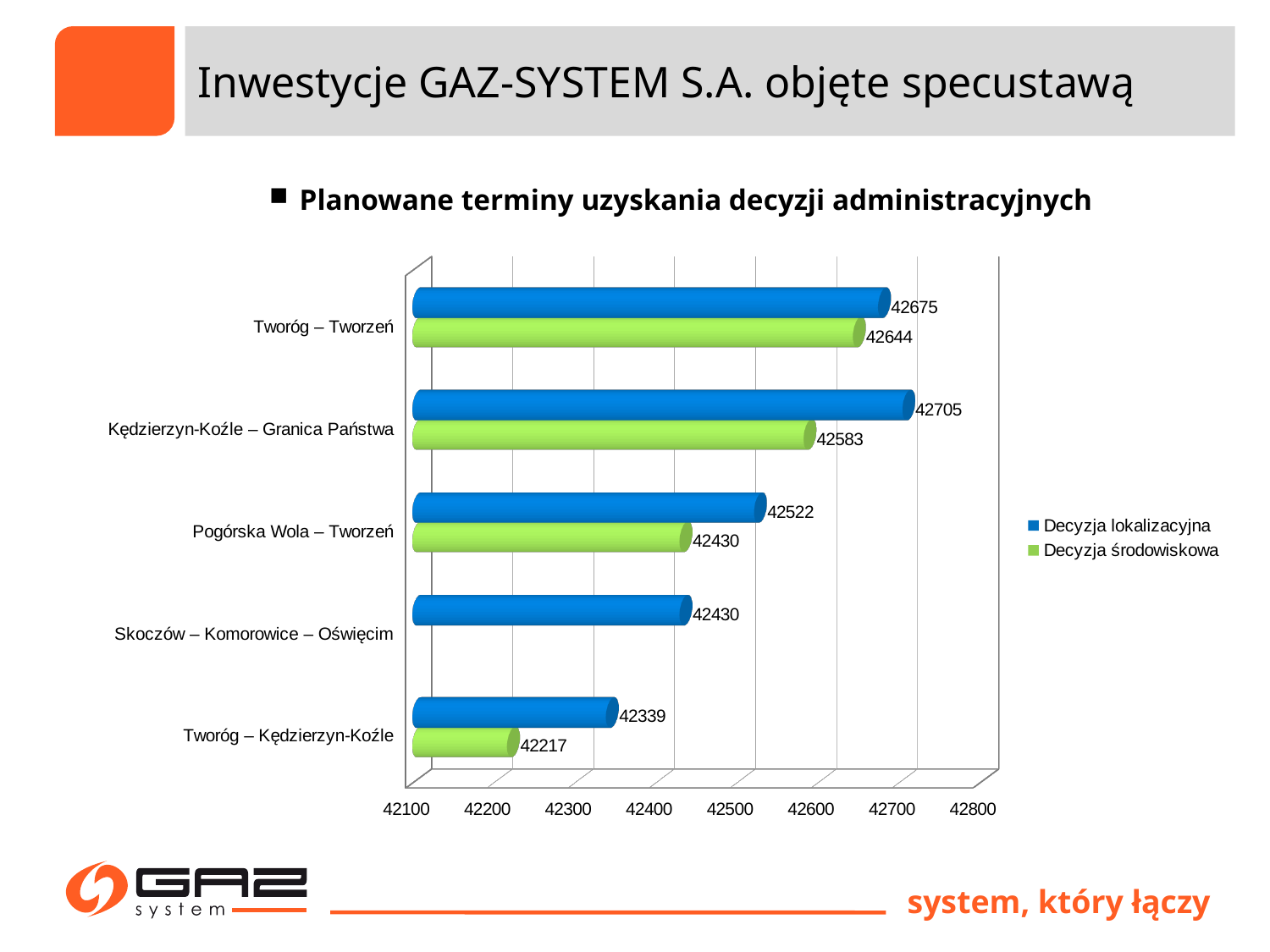
What is the value of Decyzja lokalizacyjna for Kędzierzyn-Koźle – Granica Państwa? 42705 How many categories (investments) are shown on the chart? 5 Which category has the highest value for Decyzja lokalizacyjna? Kędzierzyn-Koźle – Granica Państwa Which category has only a Decyzja lokalizacyjna bar and no Decyzja środowiskowa bar? Skoczów – Komorowice – Oświęcim What is the value of Decyzja środowiskowa for Tworóg – Kędzierzyn-Koźle? 42217 What is the difference between the Decyzja lokalizacyjna and Decyzja środowiskowa values for Kędzierzyn-Koźle – Granica Państwa? 122 What is the value of Decyzja środowiskowa for Pogórska Wola – Tworzeń? 42430 Which is larger: the Decyzja lokalizacyjna value for Tworóg – Tworzeń or for Pogórska Wola – Tworzeń? Tworóg – Tworzeń What colour are the Decyzja środowiskowa bars? green What type of chart is shown on the slide? bar chart How many series does the legend list? 2